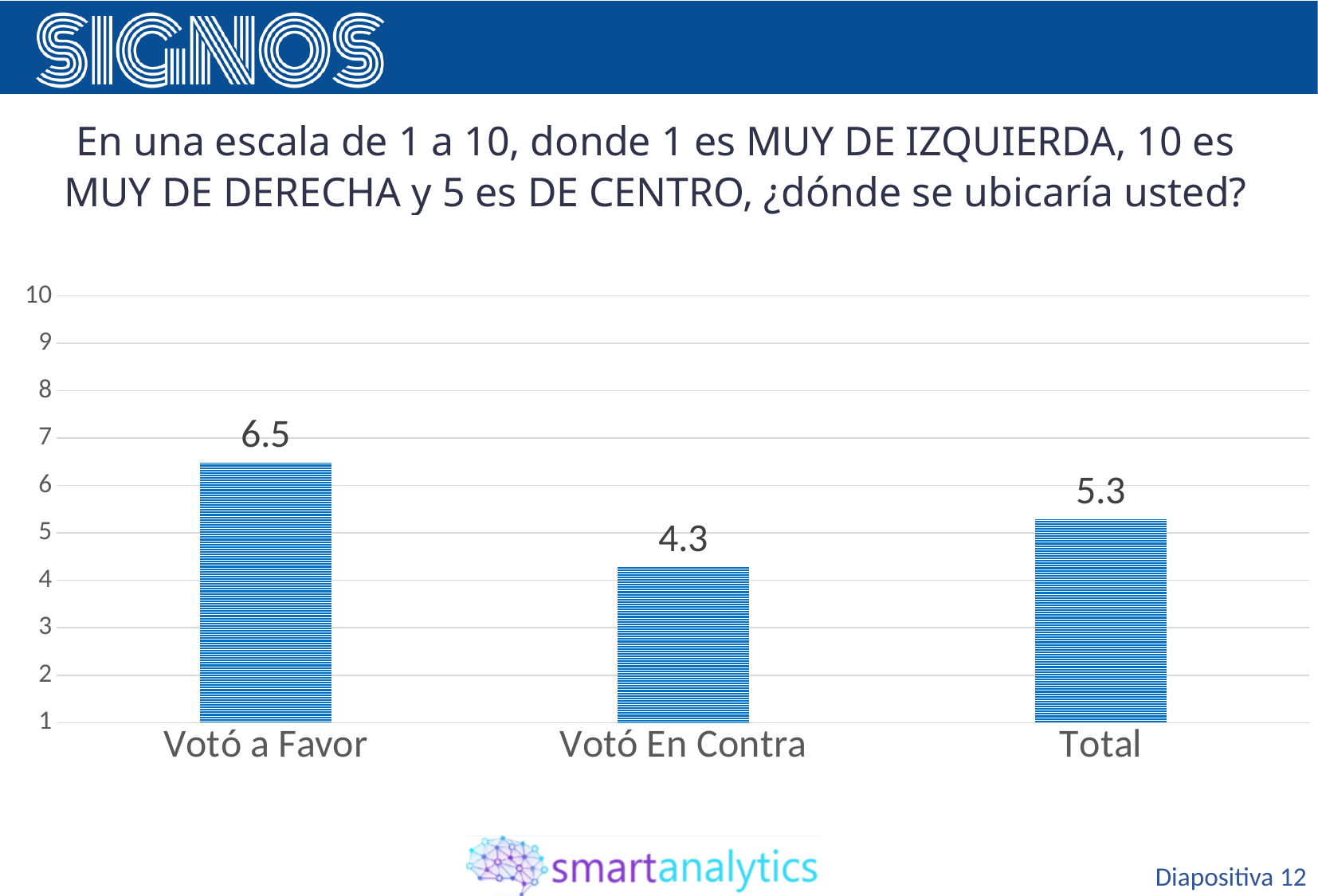
Which is larger, the value for Votó En Contra or the value for Total? Total How many categories are shown on the x axis? 3 What is the value for Votó a Favor? 6.5 What kind of chart is shown on the slide? bar chart What is the value for Votó En Contra? 4.3 What is the value for Total? 5.3 What is the difference between the values for Votó a Favor and Total? 1.2 What is the difference between the values for Votó a Favor and Votó En Contra? 2.2 Which category has the highest value? Votó a Favor What is the highest value shown on the vertical axis? 10 Is the value for Votó a Favor greater or less than 6? greater Which category has the lowest value? Votó En Contra